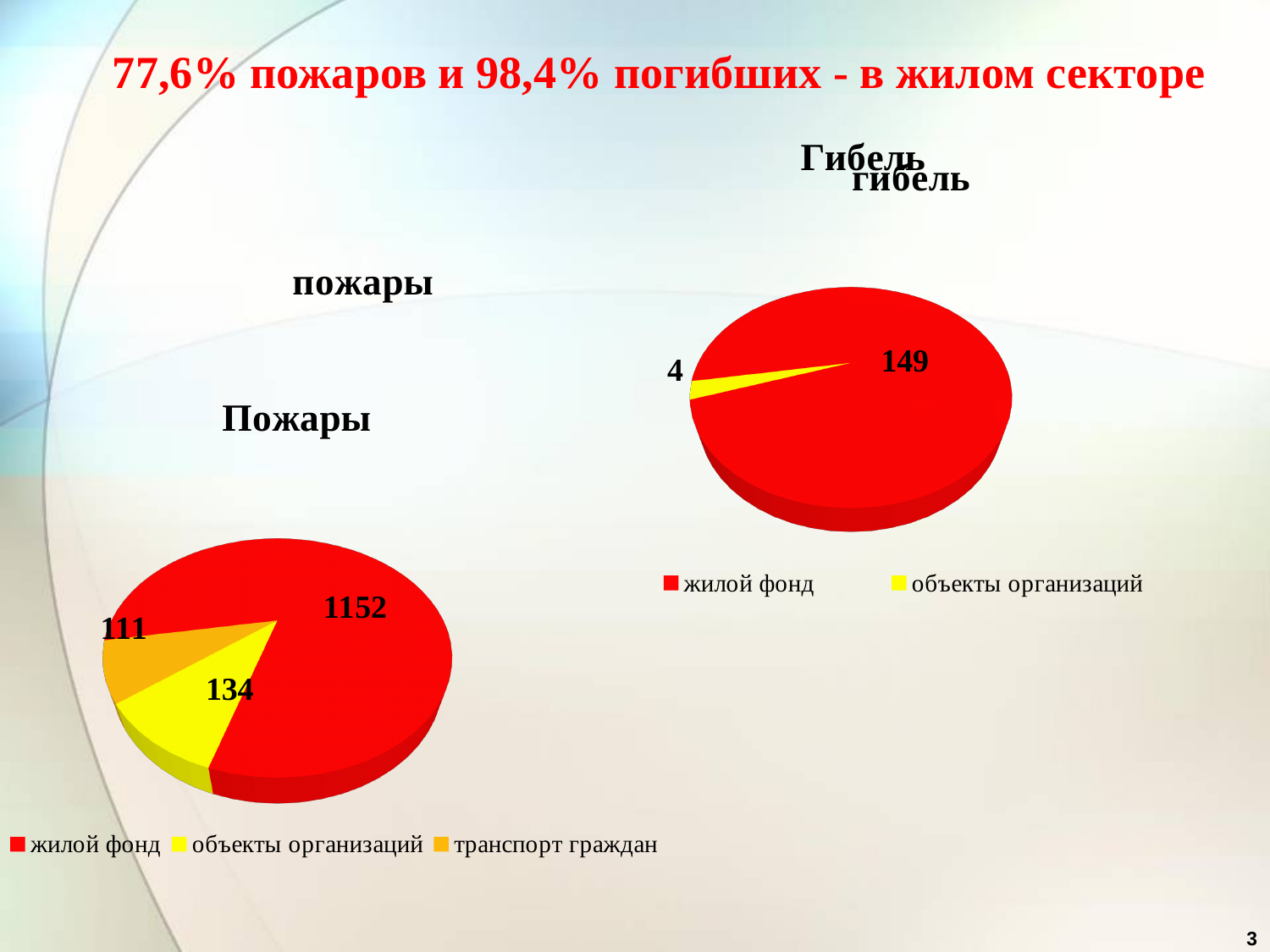
In the "Пожары" pie chart, what is the value for транспорт граждан? 111 In the "Гибель" pie chart, what is the value for жилой фонд? 149 In the "Пожары" pie chart, what is the value for объекты организаций? 134 In the "Пожары" pie chart, which category has the largest value? жилой фонд In the "Пожары" pie chart, what is the difference between жилой фонд and объекты организаций? 1018 In the "Пожары" pie chart, how many categories are shown? 3 In the "Пожары" pie chart, what is the value for жилой фонд? 1152 In the "Гибель" pie chart, how many categories are shown? 2 What type of chart is the "Гибель" chart? Pie chart In the "Гибель" pie chart, what is the value for объекты организаций? 4 In the "Гибель" pie chart, what is the difference between жилой фонд and объекты организаций? 145 In the "Пожары" pie chart, which category has the smallest value? транспорт граждан